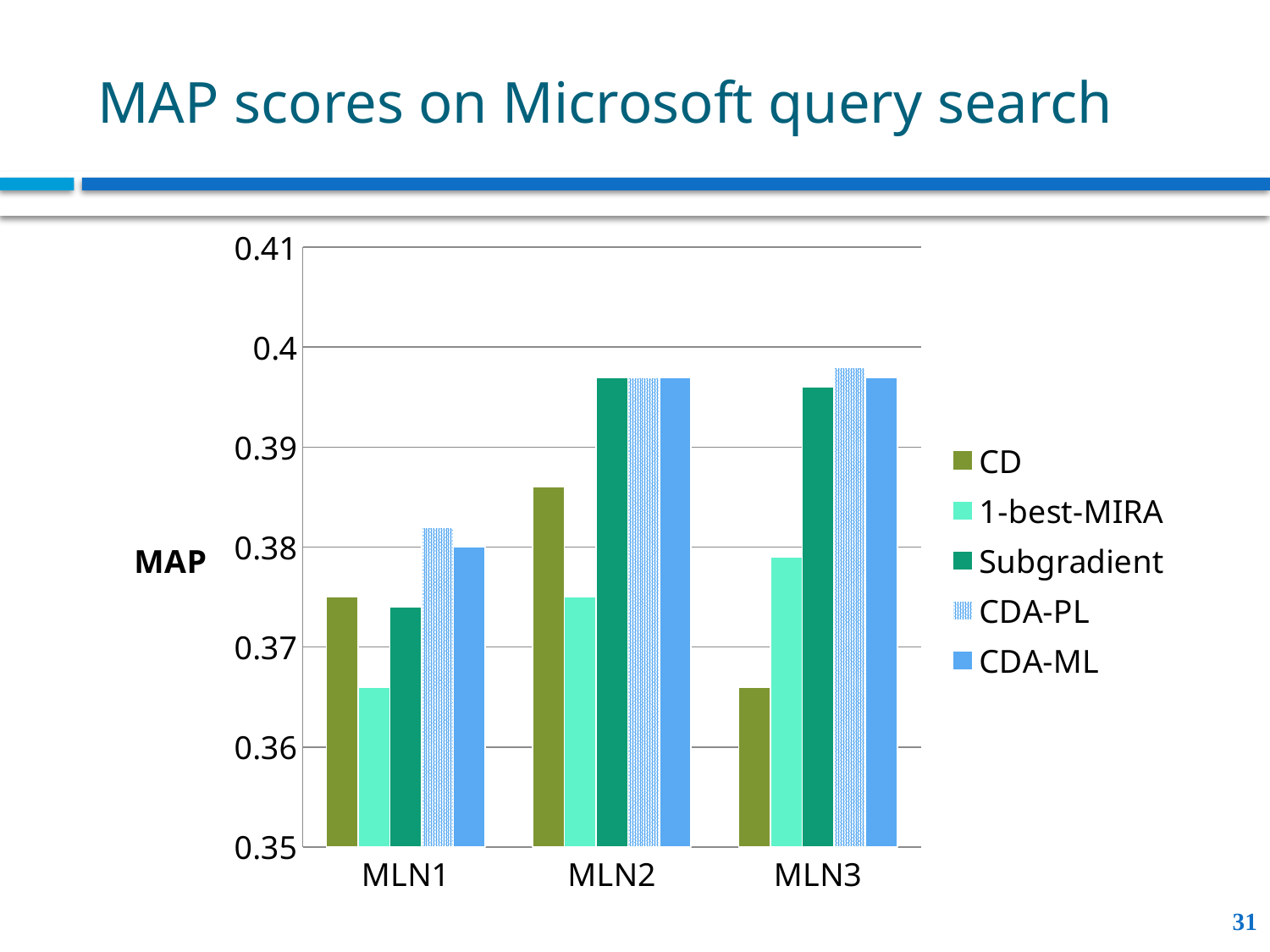
At MLN3, which is larger: CD or 1-best-MIRA? 1-best-MIRA Is the value for CDA-ML at MLN2 greater or less than 0.39? greater What kind of chart is shown on the slide? bar chart Is the value for 1-best-MIRA at MLN1 greater or less than 0.37? less How many series does the legend list? 5 How many categories are shown on the x axis? 3 At MLN1, which is larger: CD or 1-best-MIRA? CD Which series has the lowest value at MLN3? CD Is the value for Subgradient at MLN3 greater or less than 0.39? greater What is the label on the y axis? MAP Which is larger: the CD value at MLN2 or the CD value at MLN3? MLN2